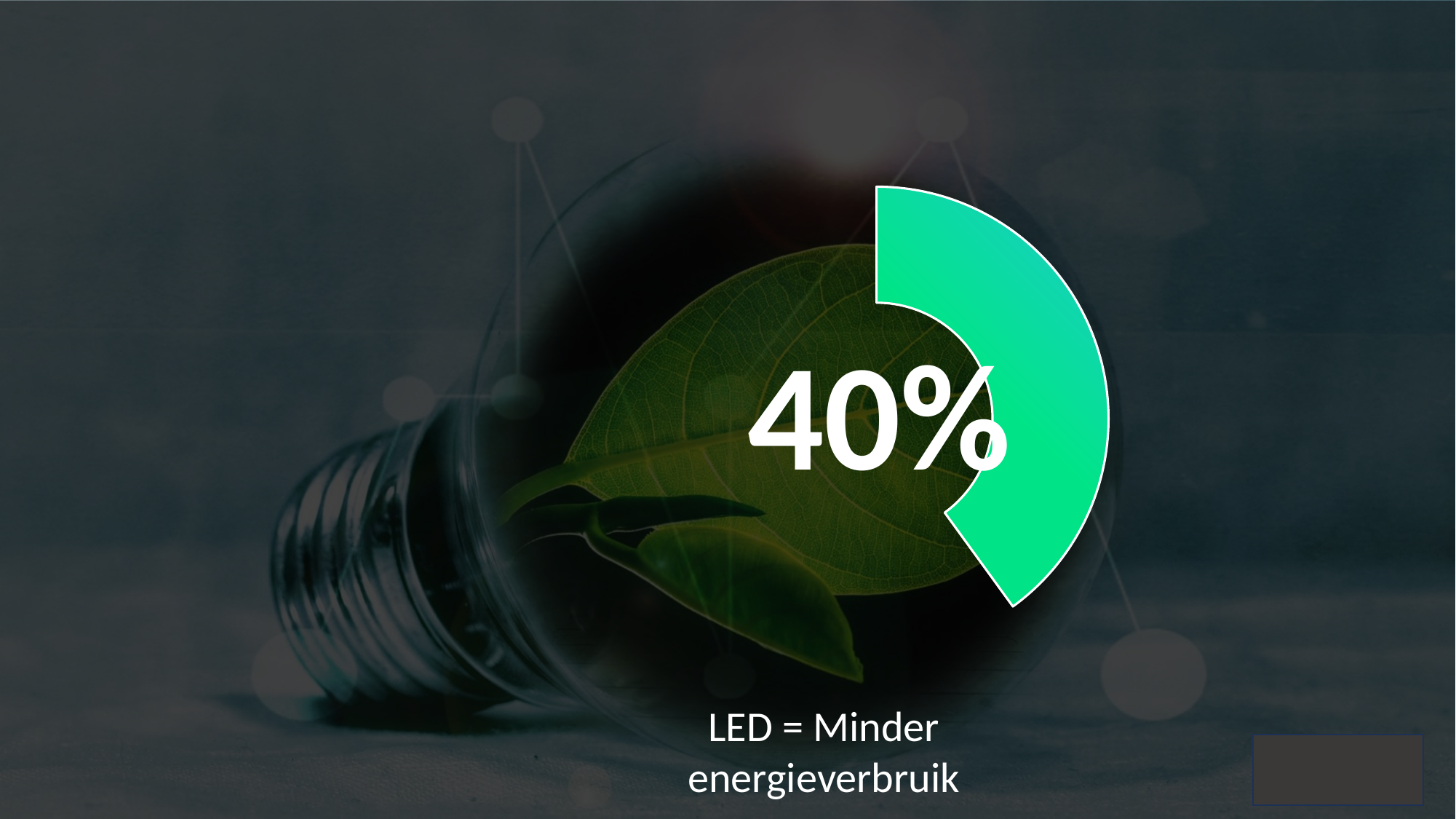
What share of the doughnut chart does the green segment represent? 40% Is the value shown by the green segment greater or less than 25%? greater What percentage is printed in the centre of the doughnut chart? 40% What caption appears below the doughnut chart? LED = Minder energieverbruik How many coloured segments are visible in the doughnut chart? 1 What colour is the filled segment of the doughnut chart? green Is the value shown by the green segment greater or less than 50%? less What kind of chart is shown on the slide? doughnut chart